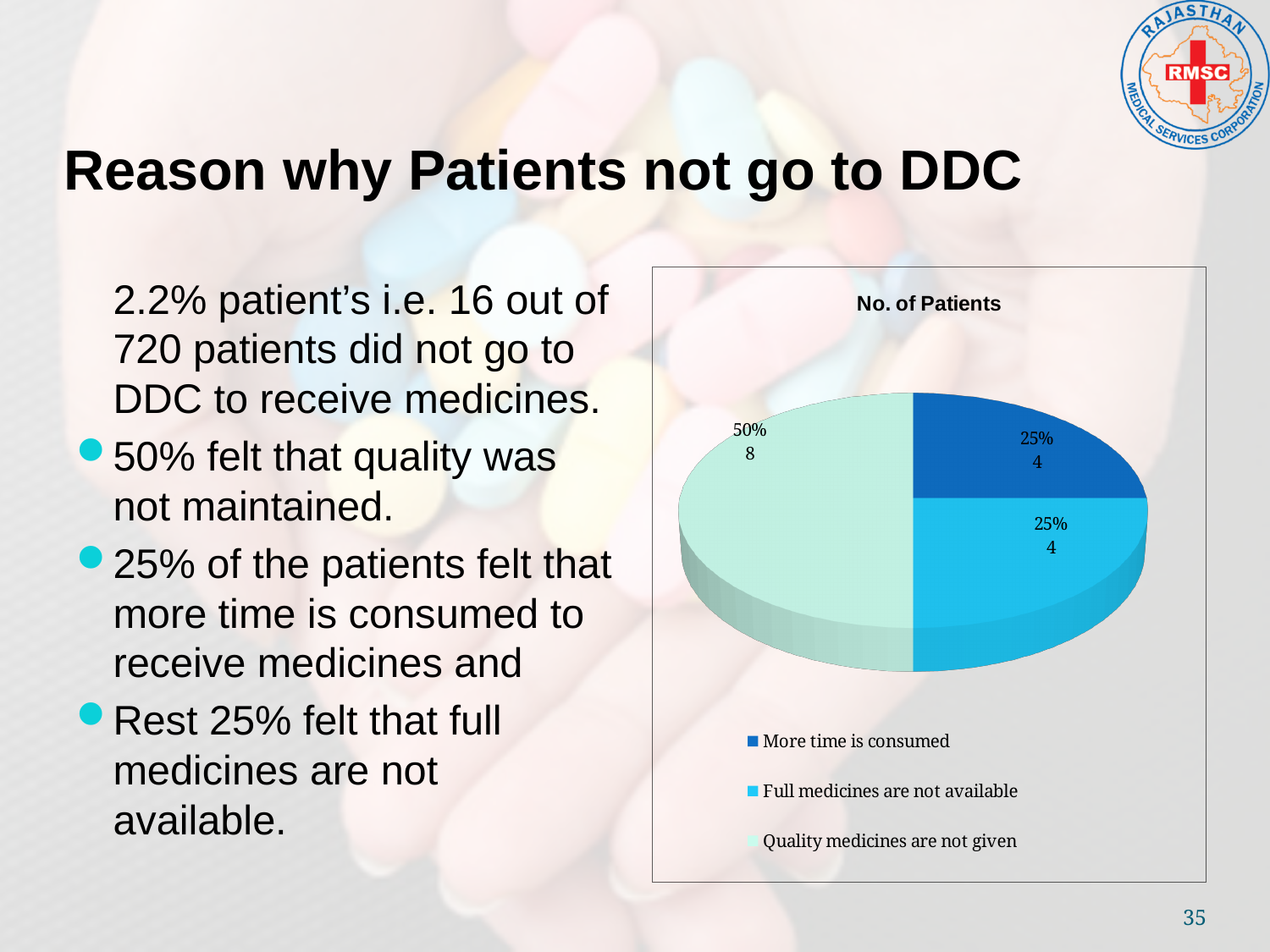
What is the number of patients for 'Full medicines are not available'? 4 What is the number of patients for 'Quality medicines are not given'? 8 Which is larger: the number of patients for 'Quality medicines are not given' or for 'More time is consumed'? Quality medicines are not given What is the number of patients for 'More time is consumed'? 4 Which reason has the largest share of the pie? Quality medicines are not given What share of the pie does 'Quality medicines are not given' represent? 50% What kind of chart is shown on the slide? pie chart What share of the pie does 'More time is consumed' represent? 25% How many entries does the chart legend list? 3 What is the title of the chart? No. of Patients How many slices does the pie chart have? 3 What is the difference in number of patients between 'Quality medicines are not given' and 'Full medicines are not available'? 4